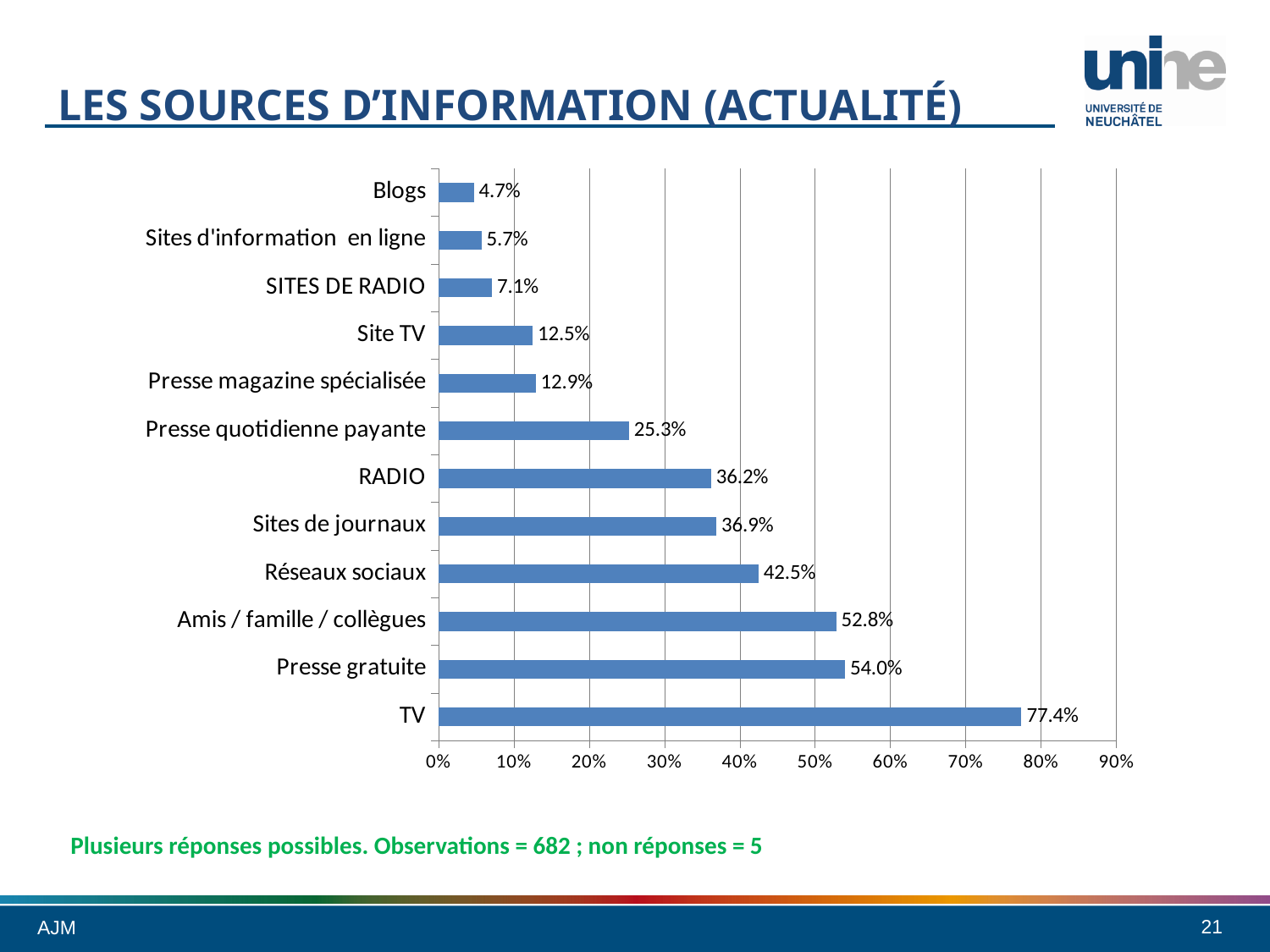
Is the value for Amis / famille / collègues greater or less than 50%? greater What is the value for Presse quotidienne payante? 25.3% What is the value for Réseaux sociaux? 42.5% What is the value for TV? 77.4% Which is larger, the value for RADIO or the value for Presse quotidienne payante? RADIO Which category has the lowest value? Blogs What is the difference between the values for Site TV and SITES DE RADIO? 5.4% What kind of chart is shown on the slide? bar chart Which category has the highest value? TV How many categories are shown in the chart? 12 What is the difference between the values for TV and Presse gratuite? 23.4% What is the title of the slide containing the chart? LES SOURCES D'INFORMATION (ACTUALITÉ)